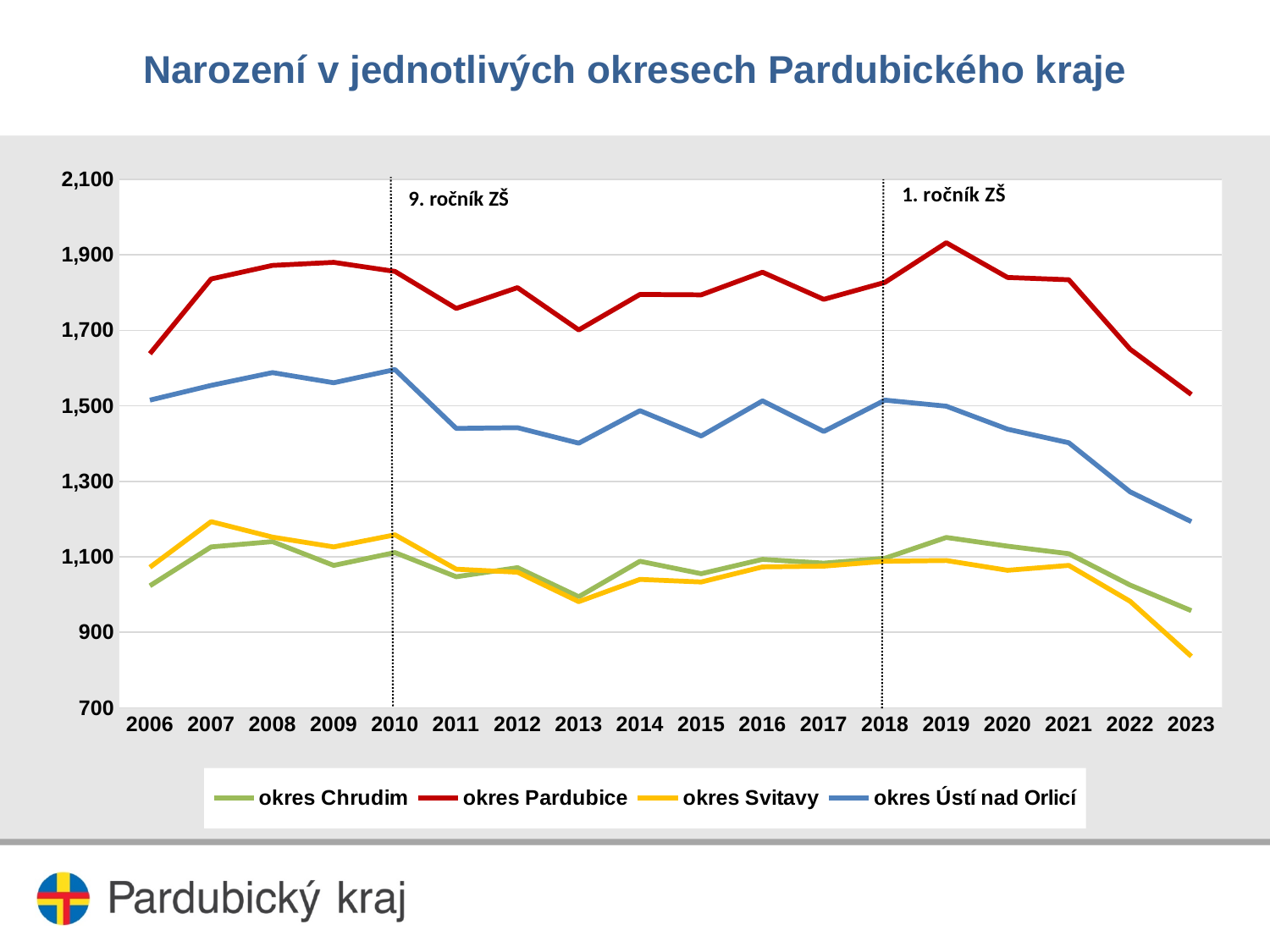
Which series has the highest values across the whole period? okres Pardubice Is the value for okres Pardubice in 2019 greater or less than 1,900? greater What label is written next to the dotted vertical line at 2018? 1. ročník ZŠ What kind of chart is shown on the slide? line chart Do the values for okres Ústí nad Orlicí rise or fall from 2018 to 2023? fall Is the value for okres Svitavy in 2023 greater or less than 900? less In 2023, which is larger: okres Chrudim or okres Svitavy? okres Chrudim In which year does okres Svitavy reach its lowest value? 2023 In which year does okres Pardubice reach its highest value? 2019 Is the value for okres Ústí nad Orlicí in 2023 greater or less than 1,300? less How many series does the legend list? 4 How many years are plotted along the x axis? 18